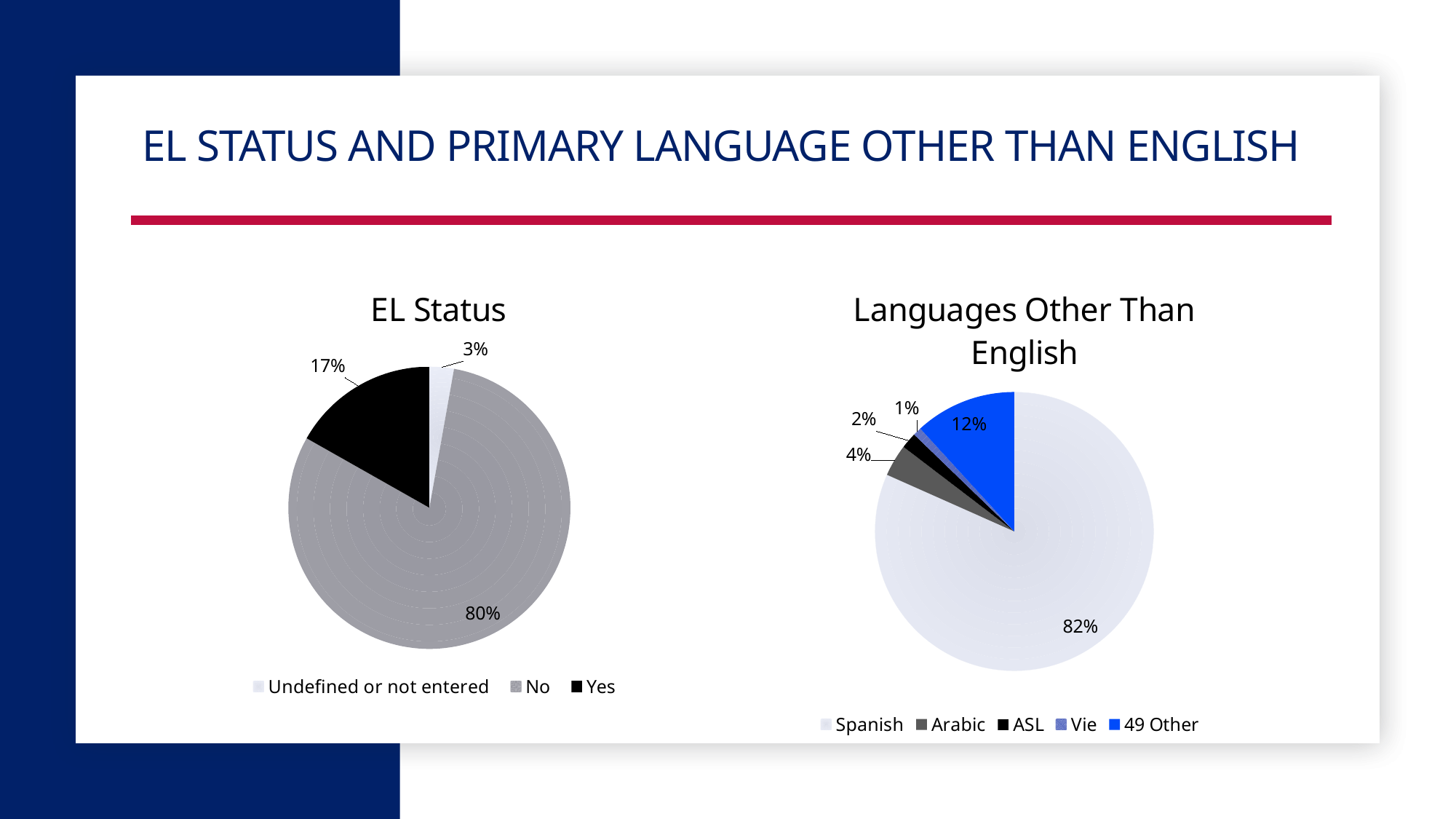
In the EL Status chart, what is the difference in percentage points between No and Yes? 63 In the EL Status chart, what percentage is shown for Undefined or not entered? 3% In the Languages Other Than English chart, how many categories does the legend list? 5 In the EL Status chart, what percentage is shown for Yes? 17% In the EL Status chart, which category has the smallest slice? Undefined or not entered In the Languages Other Than English chart, what share of the pie is Spanish? 82% In the Languages Other Than English chart, what percentage is shown for 49 Other? 12% In the Languages Other Than English chart, which language has the smallest slice? Vie In the EL Status chart, which category has the largest slice? No In the Languages Other Than English chart, what percentage is shown for Arabic? 4% In the EL Status chart, what share of the pie is labelled No? 80% What type of chart is the EL Status chart? Pie chart